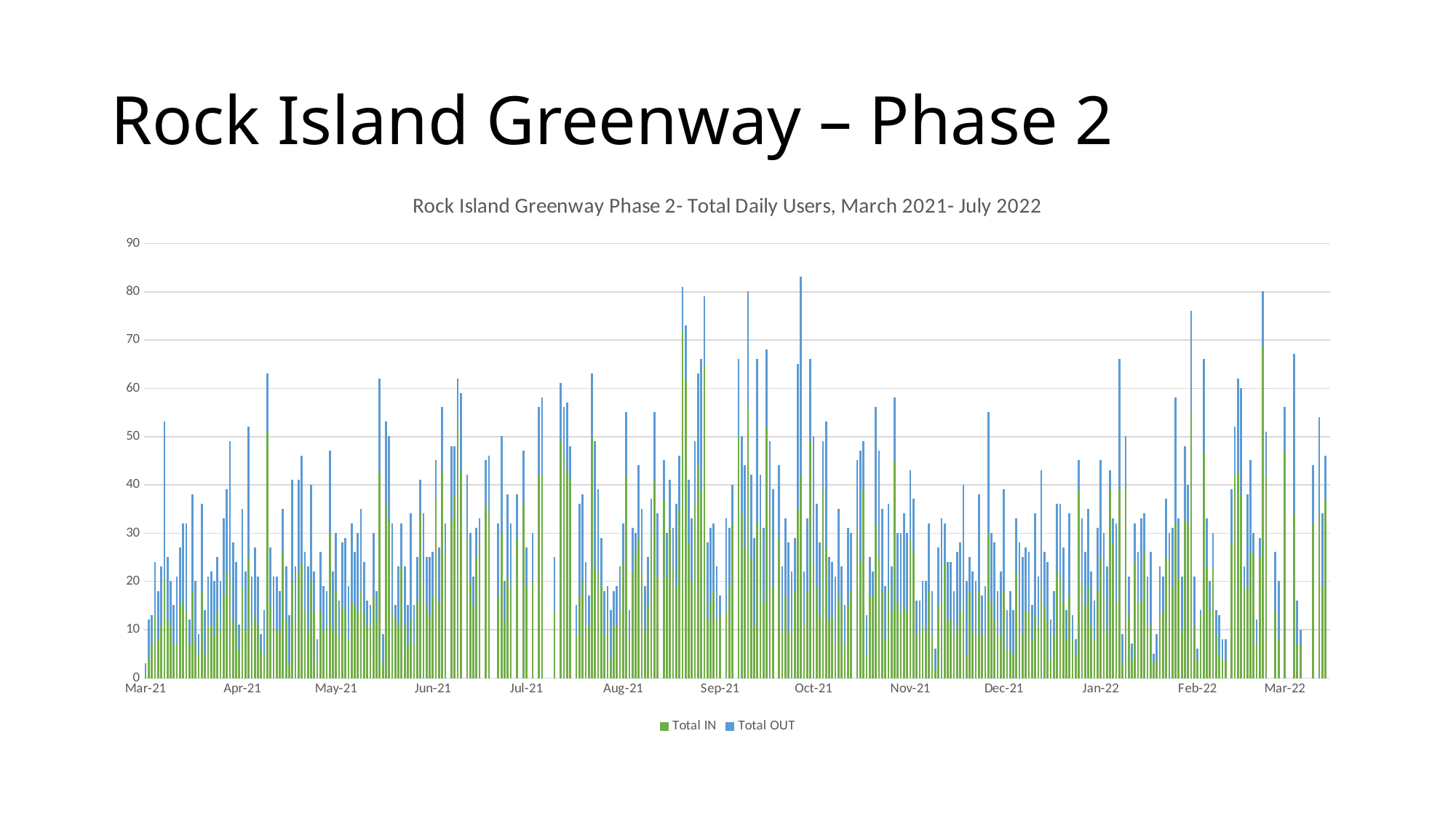
What is the last month label on the horizontal axis? Mar-22 What are the two series named in the legend? Total IN and Total OUT What is the title of the chart? Rock Island Greenway Phase 2- Total Daily Users, March 2021- July 2022 What kind of chart is shown on the slide? bar chart Is the highest value plotted on the chart greater or less than 90? less Is the highest value plotted on the chart greater or less than 80? greater How many series does the legend list? 2